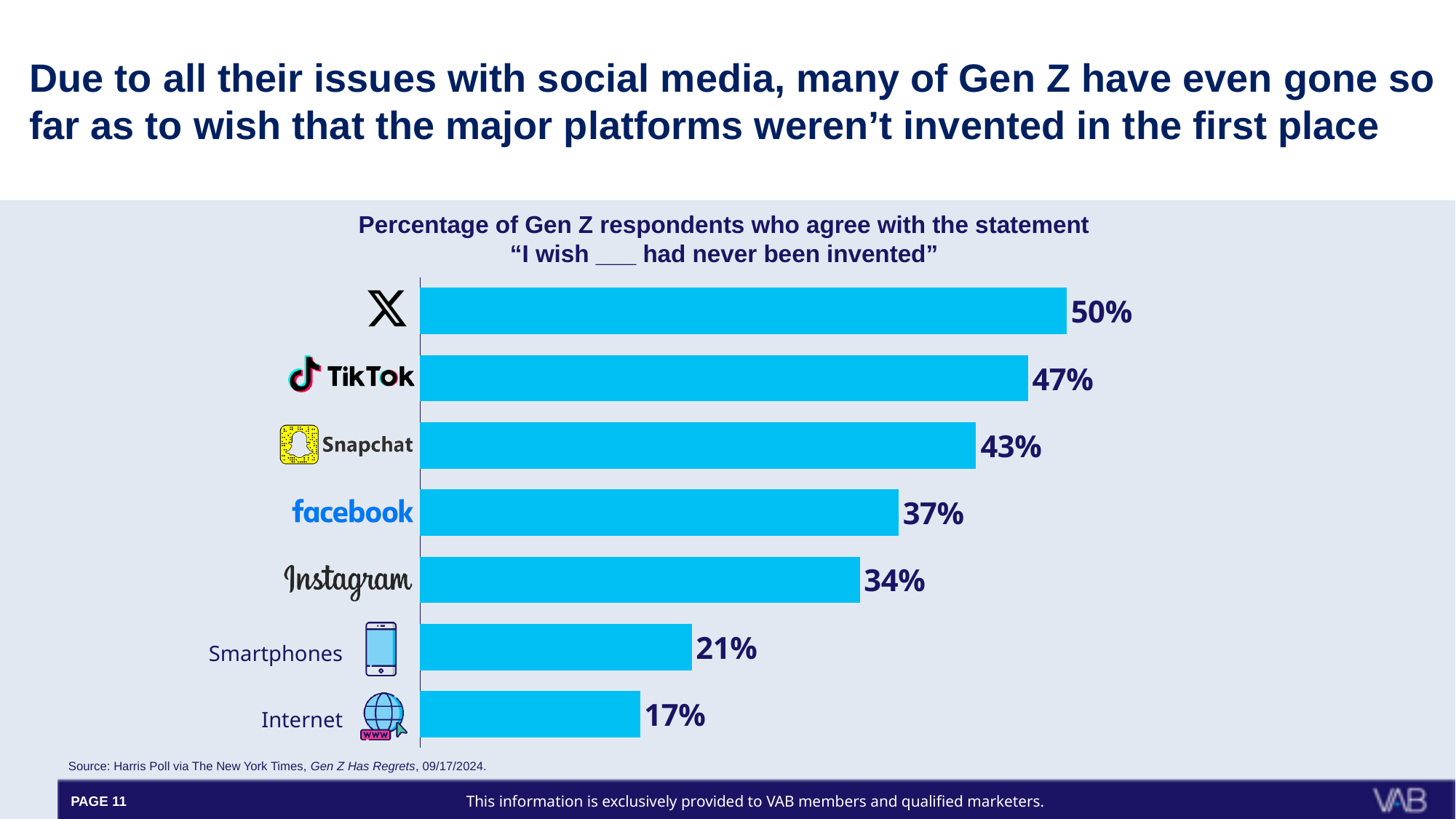
What is the difference between the values for X and Facebook? 13% Which category has the lowest percentage? Internet What is the difference between the values for Smartphones and Internet? 4% What is the value shown for Instagram? 34% What is the title of the chart? Percentage of Gen Z respondents who agree with the statement "I wish ___ had never been invented" What percentage of Gen Z respondents agree they wish TikTok had never been invented? 47% Which has a higher value, Snapchat or Instagram? Snapchat What type of chart is shown on the slide? Bar chart How many categories are shown in the chart? 7 What percentage is shown for Smartphones? 21% What is the value shown for Snapchat? 43% Which category has the highest percentage of respondents wishing it had never been invented? X